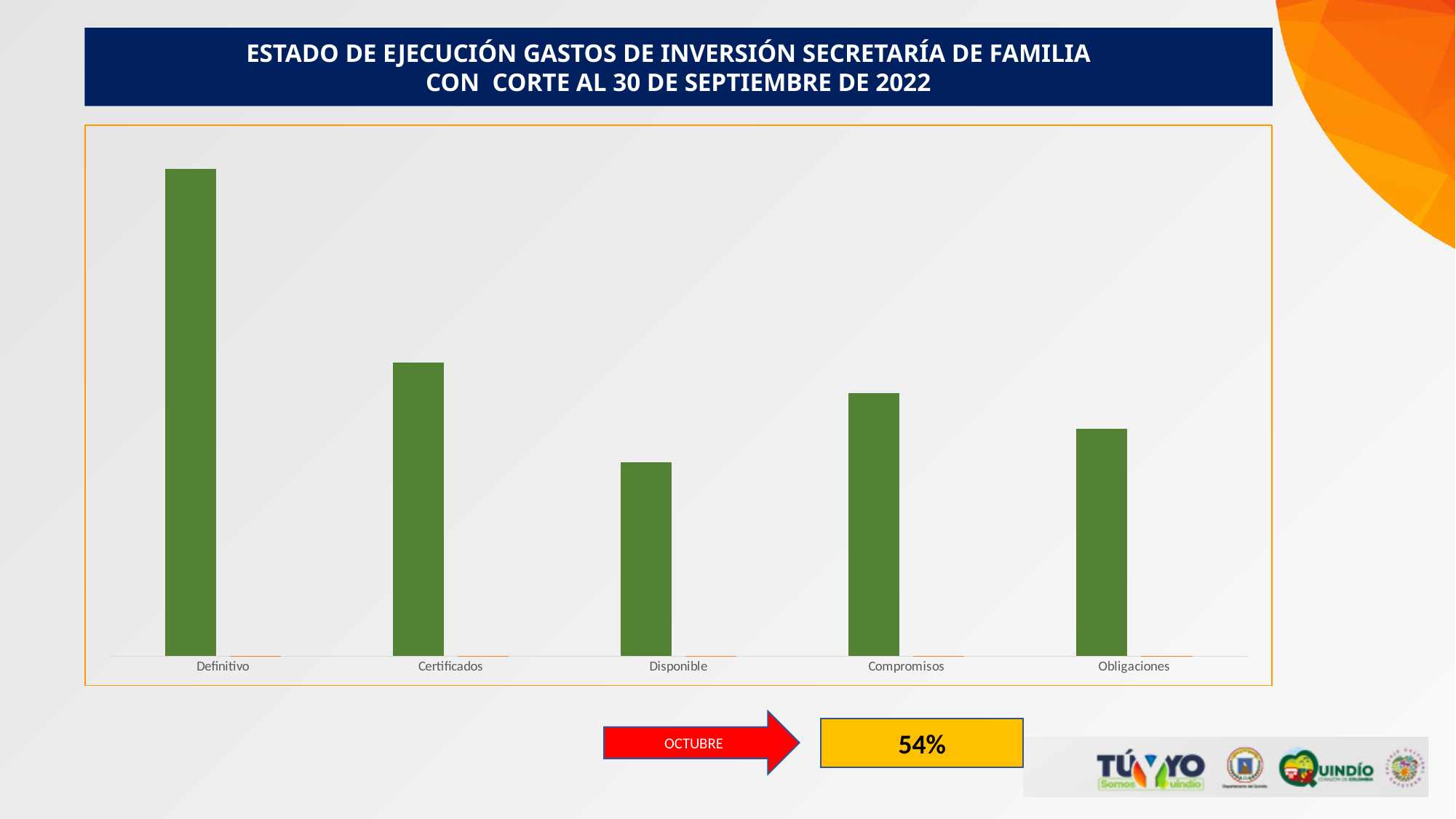
What colour are the bars in the chart? Green Which category has the highest bar in the chart? Definitivo What kind of chart is shown on the slide? Bar chart Which is larger, the bar for Definitivo or the bar for Certificados? Definitivo What is the title shown above the chart? ESTADO DE EJECUCIÓN GASTOS DE INVERSIÓN SECRETARÍA DE FAMILIA CON CORTE AL 30 DE SEPTIEMBRE DE 2022 How many categories are plotted in the chart? 5 What is the label of the first category on the x axis? Definitivo Do the bars decrease steadily from left to right across the chart? No Which is larger, the bar for Disponible or the bar for Obligaciones? Obligaciones Which is larger, the bar for Certificados or the bar for Compromisos? Certificados Which category has the lowest bar in the chart? Disponible